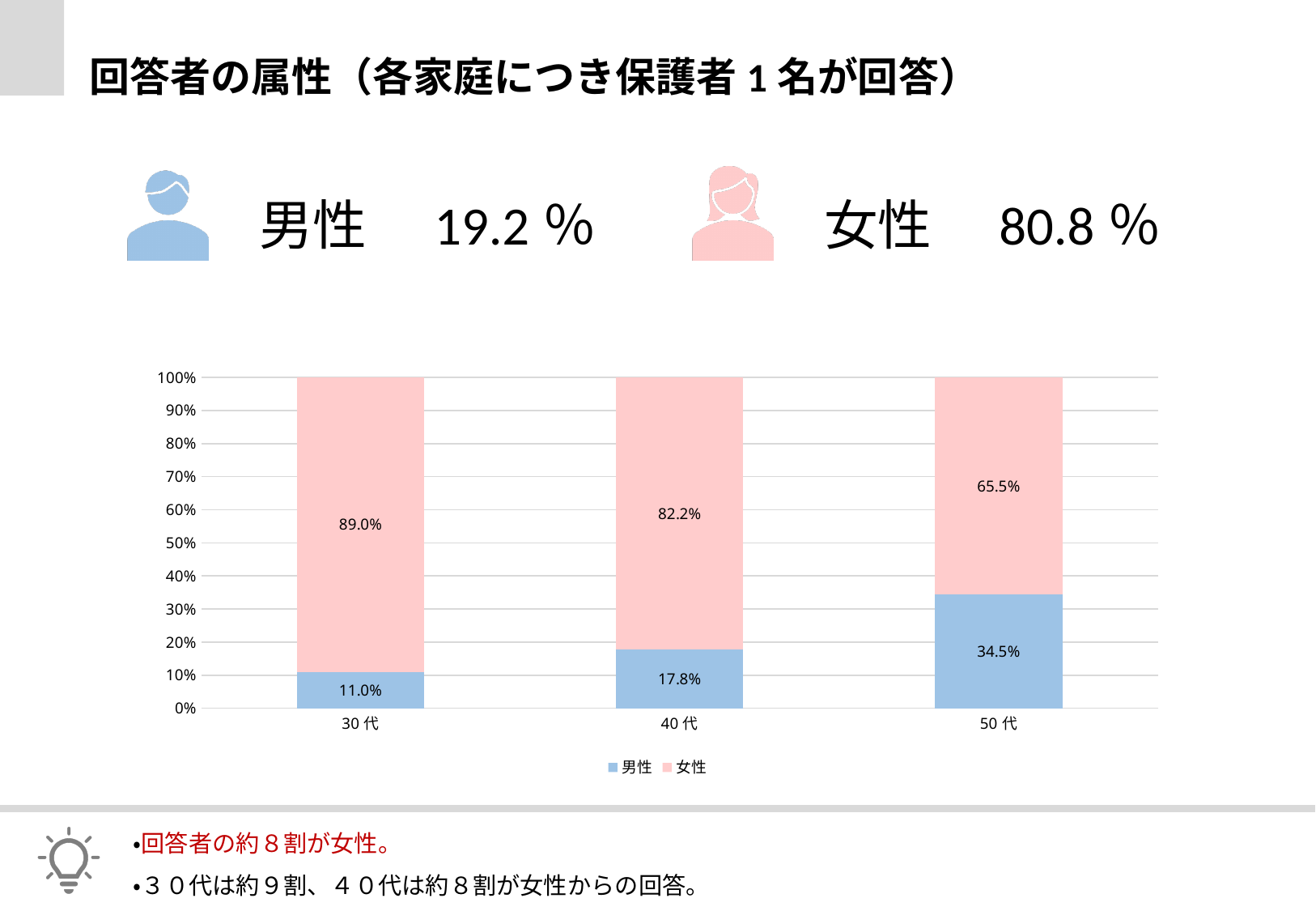
Which is larger: the 男性 value for 40代 or the 男性 value for 50代? 50代 What is the value for 女性 in the 50代 category? 65.5% What is the value for 女性 in the 40代 category? 82.2% What is the difference between the 女性 value and the 男性 value in the 40代 category? 64.4% Which age category has the lowest value for 男性? 30代 What kind of chart is shown on the slide? Stacked bar chart What is the value for 男性 in the 50代 category? 34.5% What is the value for 男性 in the 30代 category? 11.0% How many series does the legend list? 2 Does the 男性 share rise or fall as the age category increases from 30代 to 50代? Rise Which age category has the highest value for 女性? 30代 How many age categories are shown on the x axis? 3